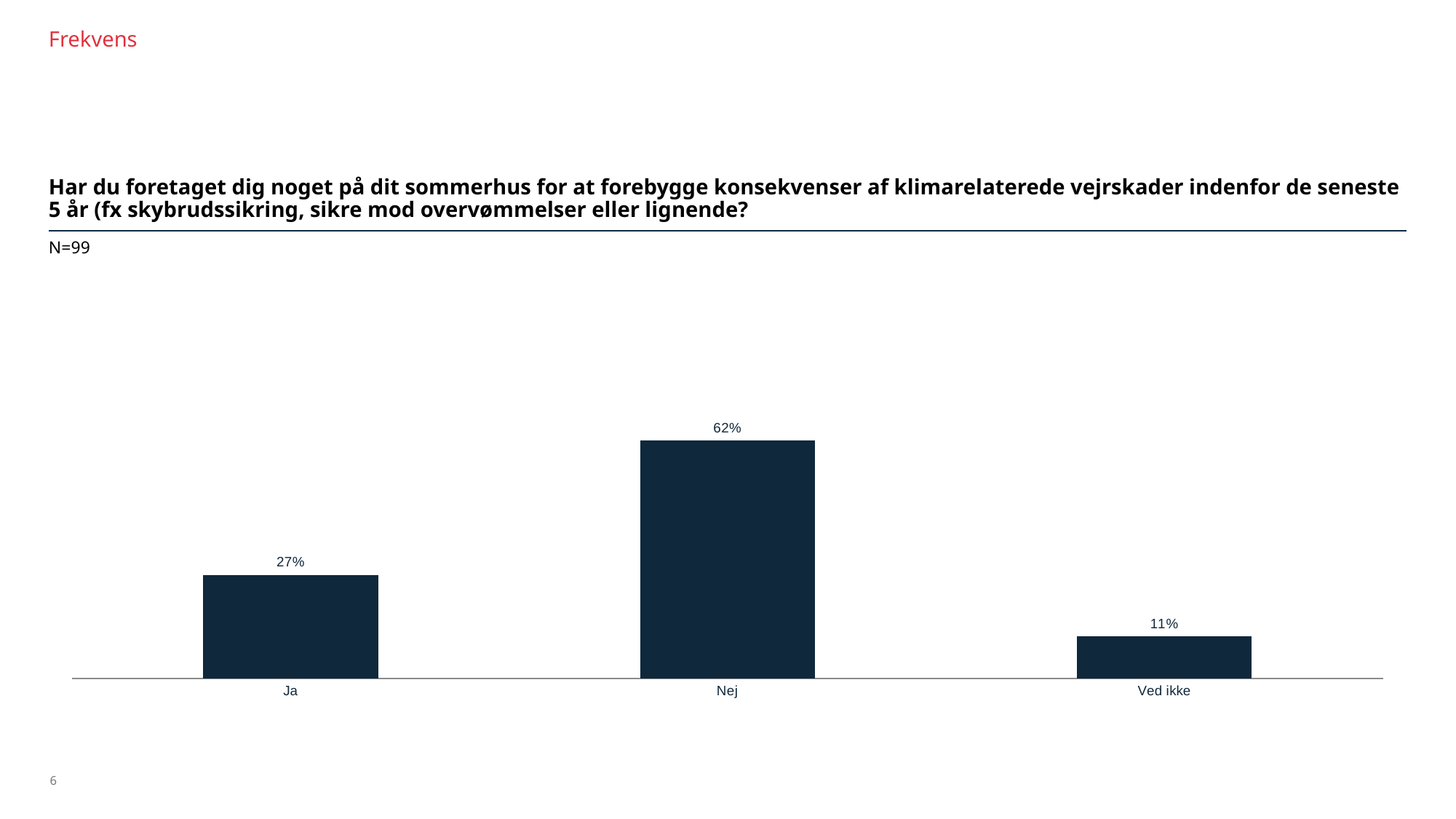
Which category has the lowest value? Ved ikke Which category has the highest value? Nej What is the difference between the values for "Ja" and "Ved ikke"? 16% How many categories are shown on the x axis? 3 Which is larger, the value for "Ja" or the value for "Ved ikke"? Ja What is the value for "Nej"? 62% What kind of chart is shown on the slide? Bar chart What is the value for "Ja"? 27% What is the sample size (N) stated on the slide? N=99 What is the difference between the values for "Nej" and "Ja"? 35% What is the label of the category with the middle bar? Nej What is the value for "Ved ikke"? 11%